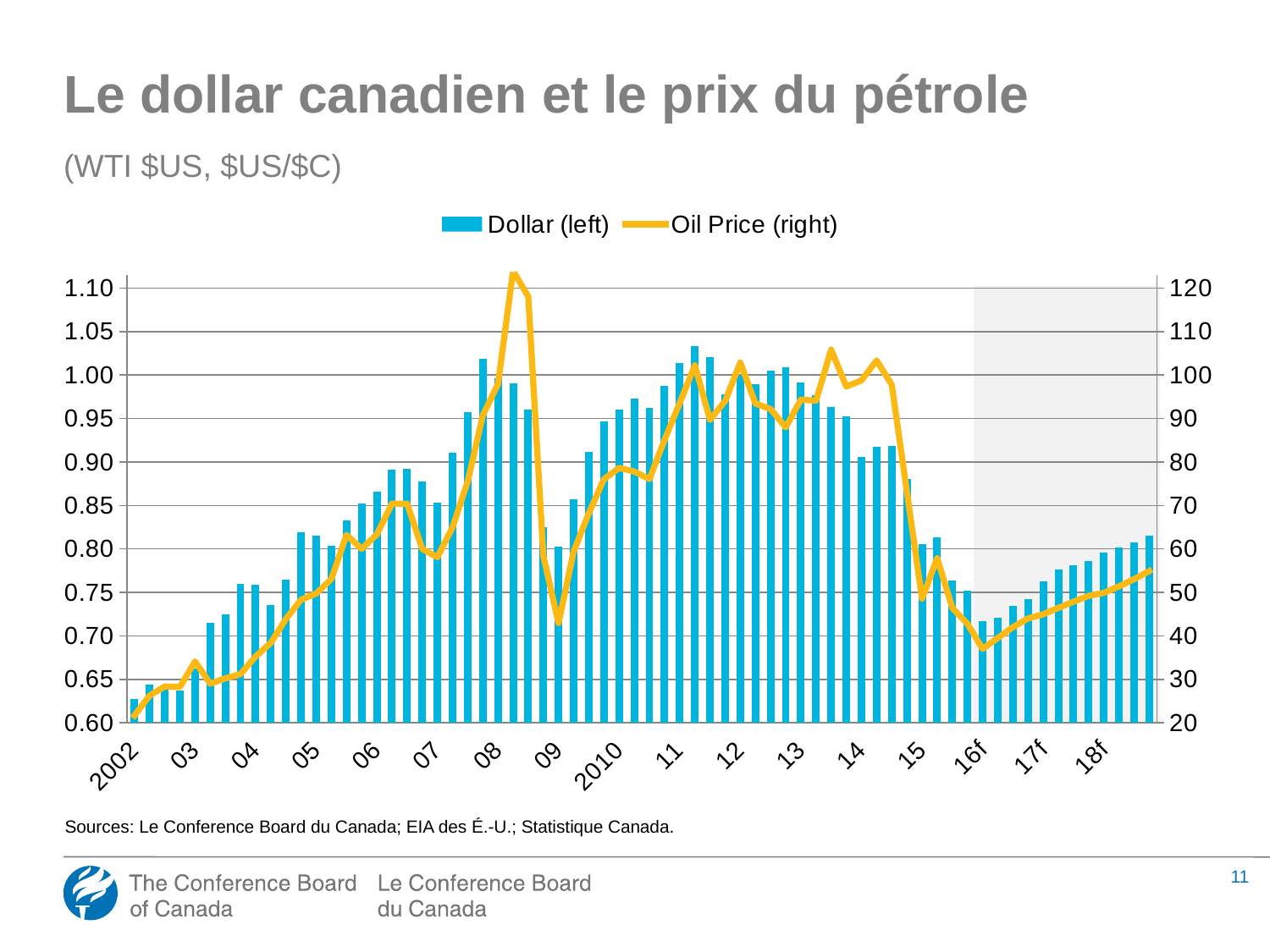
Which axis is the Oil Price series plotted against, left or right? Right What are the two series named in the legend? Dollar (left) and Oil Price (right) Is the highest Dollar value in 2011 greater or less than 1.00? greater Do the Dollar bars rise or fall from 2016f to 2018f? Rise Is the Oil Price at the start of 2002 greater or less than 30? less Is the Oil Price in 2016f greater or less than 50? less What kind of chart is shown on the slide? A combined bar and line chart In which year is the Dollar value at its lowest? 2002 In which year does the Oil Price reach its highest point? 2008 How many series does the legend list? 2